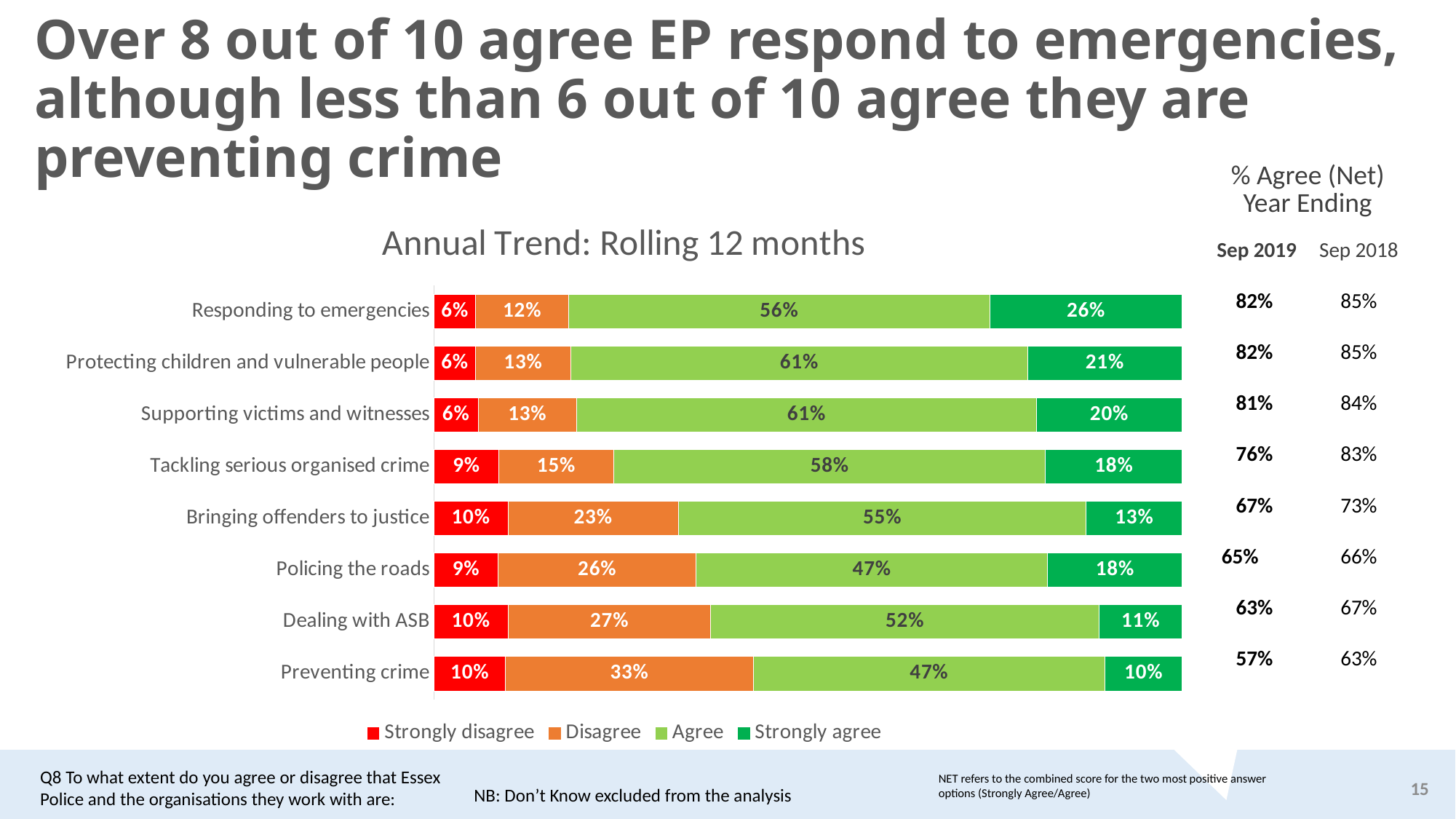
How many categories are shown in the chart? 8 What is the 'Strongly disagree' value for 'Preventing crime'? 10% What is the subtitle shown above the chart? Annual Trend: Rolling 12 months Which category has the highest 'Disagree' value? Preventing crime Which category has the highest 'Strongly agree' value? Responding to emergencies What is the difference between the 'Agree' values for 'Protecting children and vulnerable people' and 'Policing the roads'? 14% What kind of chart is shown on the slide? Stacked bar chart What percentage of respondents 'Agree' that Essex Police are responding to emergencies? 56% Which is larger: the 'Strongly agree' value for 'Tackling serious organised crime' or for 'Bringing offenders to justice'? Tackling serious organised crime How many series does the legend list? 4 Which category has the lowest 'Strongly agree' value? Preventing crime What is the 'Disagree' value for 'Policing the roads'? 26%